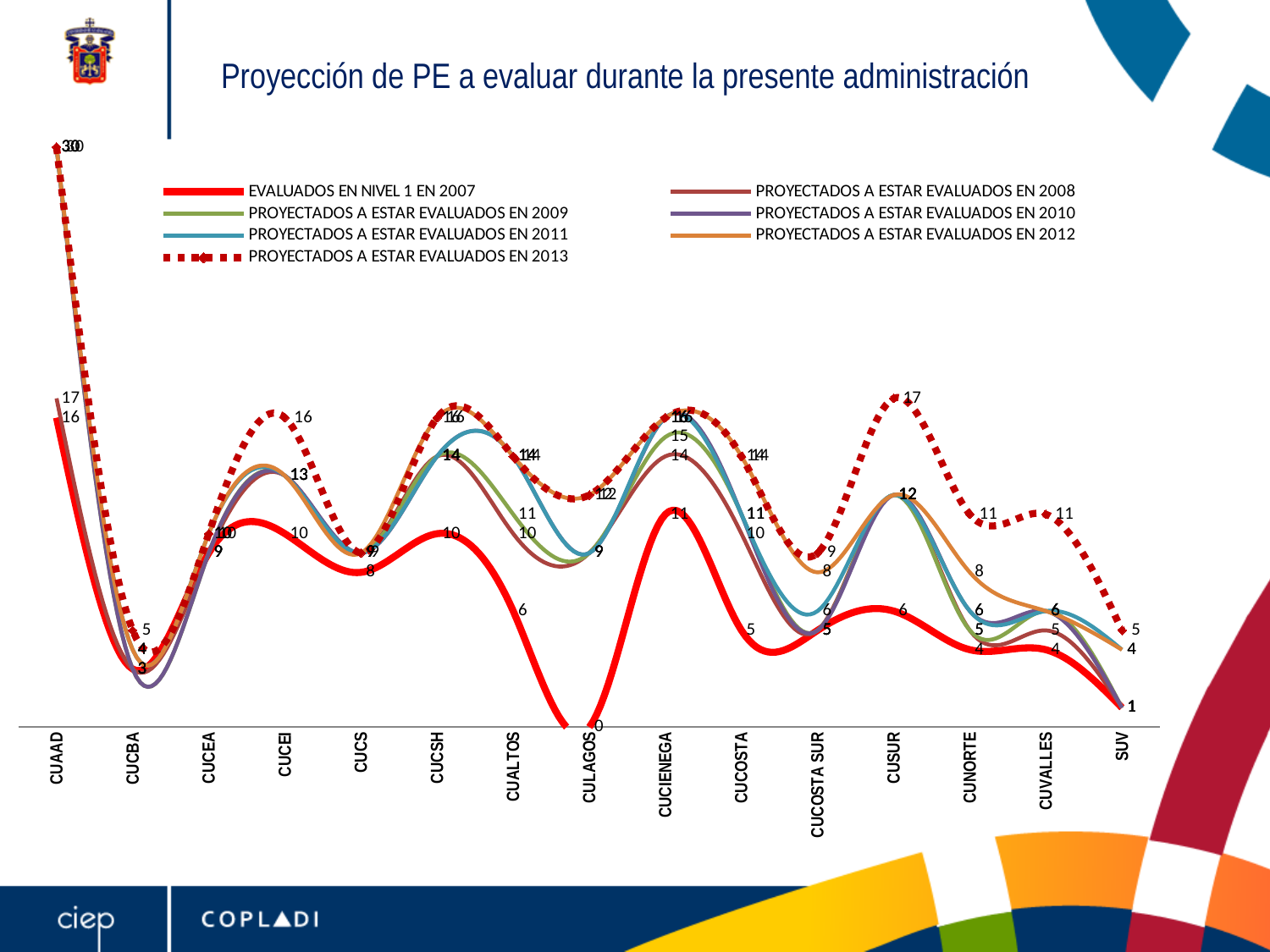
At CUSUR, which series has the larger value: EVALUADOS EN NIVEL 1 EN 2007 or PROYECTADOS A ESTAR EVALUADOS EN 2013? PROYECTADOS A ESTAR EVALUADOS EN 2013 Which category has the highest value in the series PROYECTADOS A ESTAR EVALUADOS EN 2013? CUAAD At CUSUR, what is the difference between the PROYECTADOS A ESTAR EVALUADOS EN 2013 value and the EVALUADOS EN NIVEL 1 EN 2007 value? 11 What kind of chart is shown on the slide? line chart What is the value for CULAGOS in the series EVALUADOS EN NIVEL 1 EN 2007? 0 How many series does the legend list? 7 Which category has the lowest value in the series EVALUADOS EN NIVEL 1 EN 2007? CULAGOS What is the value for CUAAD in the series PROYECTADOS A ESTAR EVALUADOS EN 2013? 30 What is the value for CUSUR in the series PROYECTADOS A ESTAR EVALUADOS EN 2013? 17 How many categories (centros) are shown along the x axis? 15 Which series is drawn as a dashed line? PROYECTADOS A ESTAR EVALUADOS EN 2013 What is the value for CUCEI in the series PROYECTADOS A ESTAR EVALUADOS EN 2013? 16